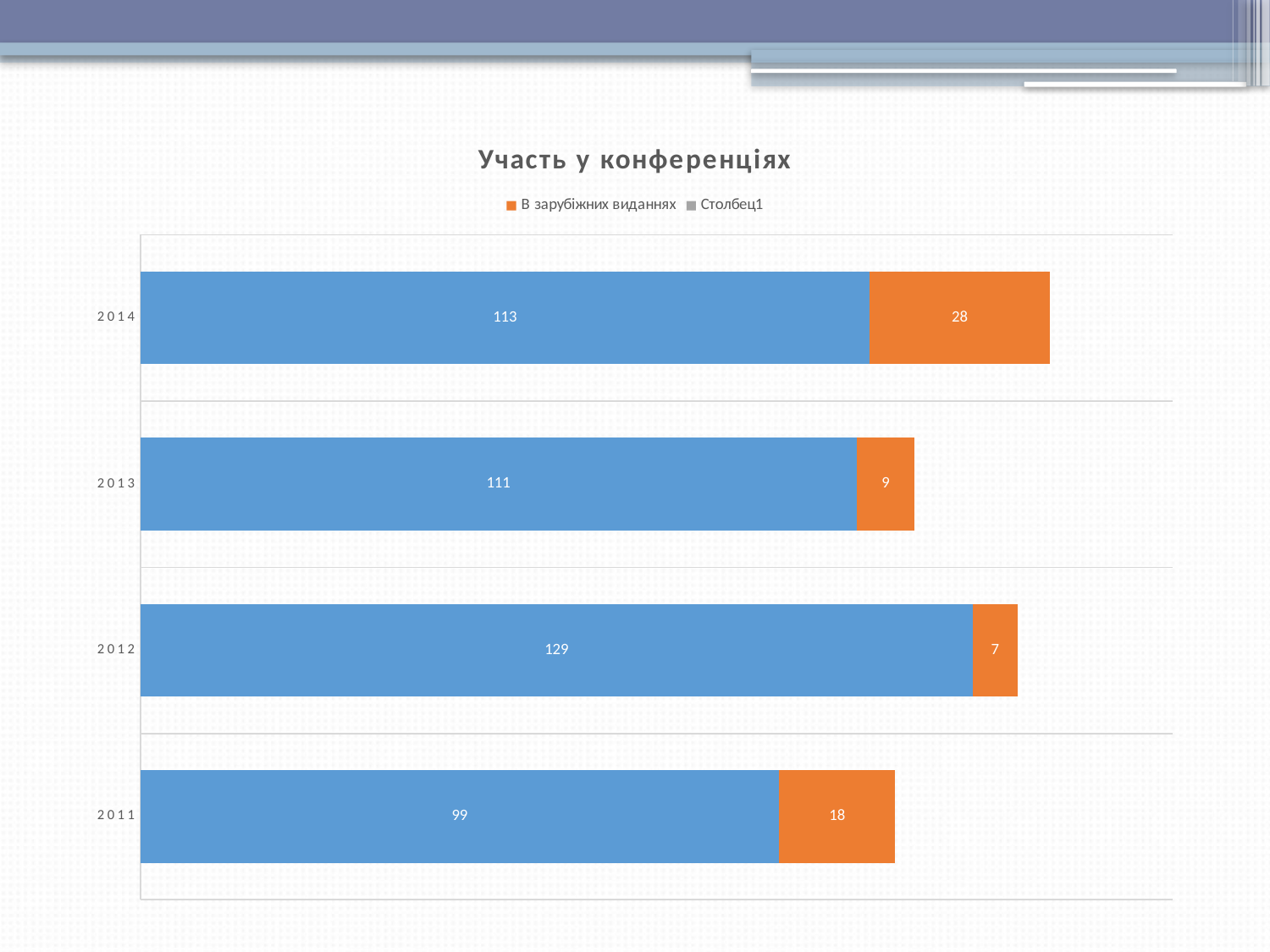
What is the value of the blue segment for 2012? 129 Which year has the largest blue segment? 2012 What is the total of the stacked bar for 2014? 141 How many entries does the legend list? 2 What is the value of the "В зарубіжних виданнях" segment for 2011? 18 What is the value of the "В зарубіжних виданнях" segment for 2014? 28 How many years are shown on the chart? 4 What is the difference between the "В зарубіжних виданнях" values for 2014 and 2013? 19 What kind of chart is shown on the slide? Stacked bar chart Which year has the smallest "В зарубіжних виданнях" value? 2012 Which year has the larger blue segment, 2013 or 2011? 2013 What is the title of the chart? Участь у конференціях